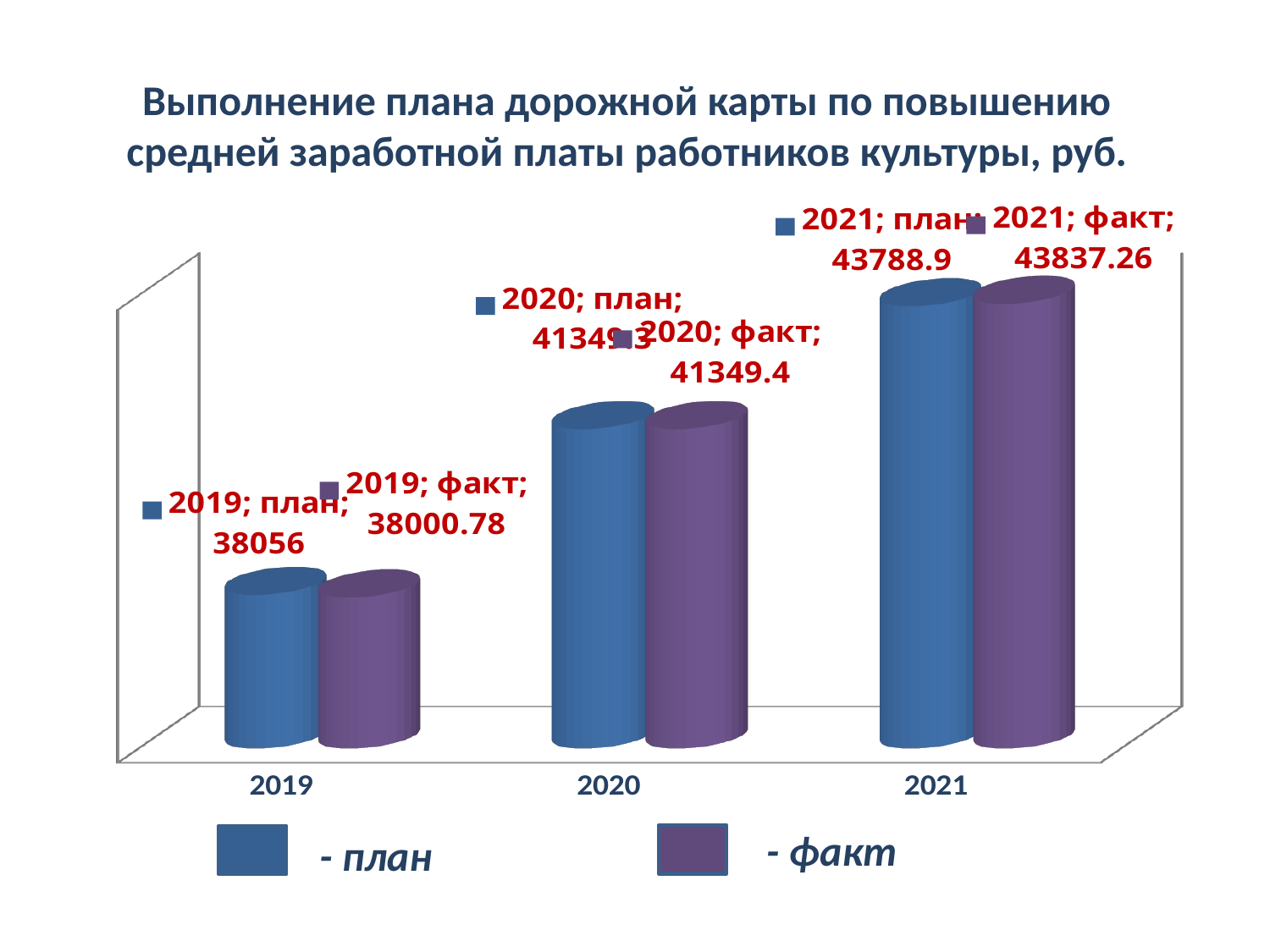
What is the difference between план and факт in 2019? 55.22 What is the value for факт in 2021? 43837.26 Which is larger in 2021, план or факт? факт How many years are shown on the x axis? 3 What is the value for факт in 2019? 38000.78 How many series does the legend list? 2 In which year is the план value the lowest? 2019 In which year is the факт value the highest? 2021 What is the value for план in 2019? 38056 What is the value for факт in 2020? 41349.4 What is the value for план in 2021? 43788.9 Do the план values rise or fall from 2019 to 2021? rise